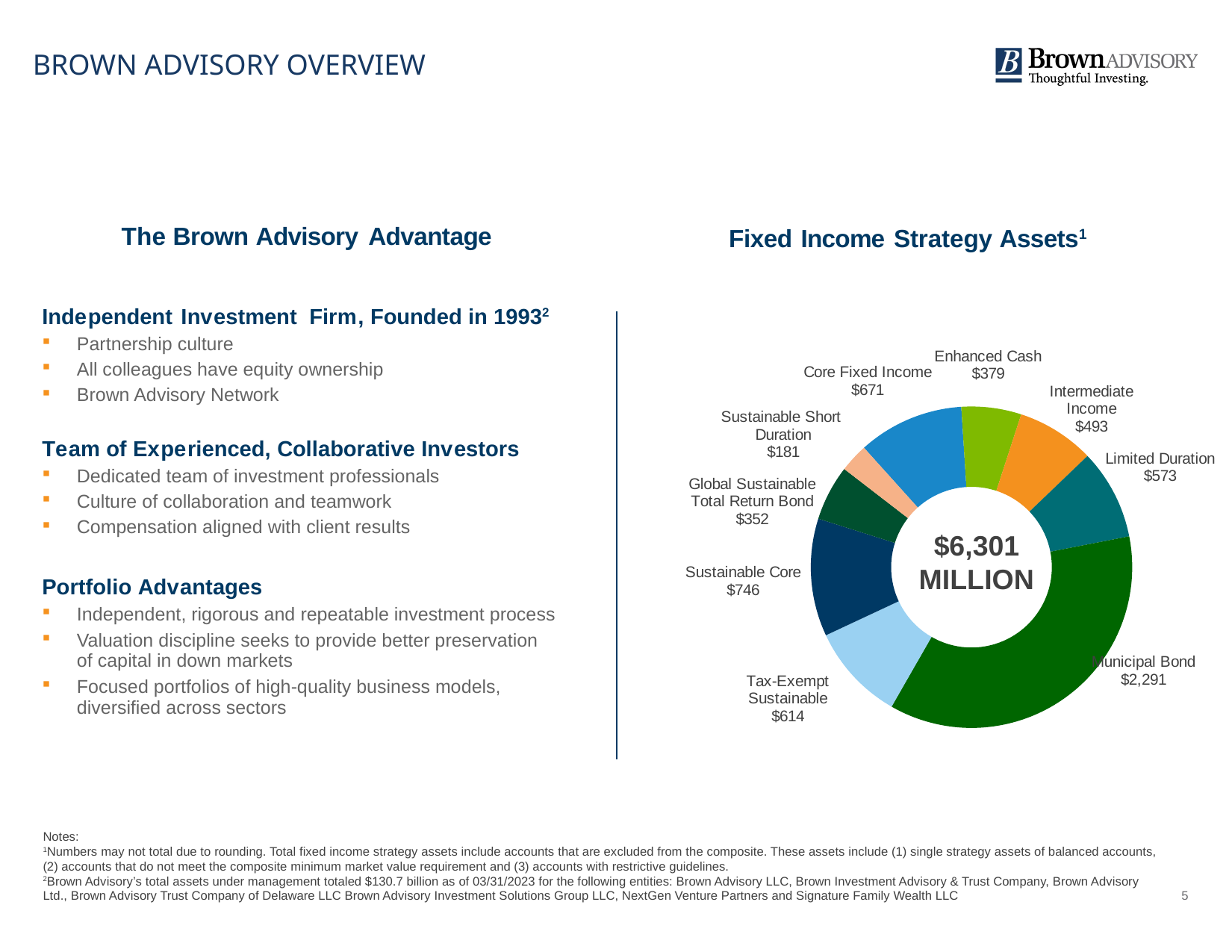
In the Fixed Income Strategy Assets chart, what is the value for Sustainable Short Duration? $181 In the Fixed Income Strategy Assets chart, what is the value for Tax-Exempt Sustainable? $614 Which category has the smallest value in the Fixed Income Strategy Assets chart? Sustainable Short Duration In the Fixed Income Strategy Assets chart, which is larger: Limited Duration or Intermediate Income? Limited Duration In the Fixed Income Strategy Assets chart, what is the difference between Municipal Bond and Sustainable Core? $1,545 What type of chart is shown under "Fixed Income Strategy Assets"? Pie chart (donut) In the Fixed Income Strategy Assets chart, what is the difference between Core Fixed Income and Enhanced Cash? $292 In the Fixed Income Strategy Assets chart, what is the value for Municipal Bond? $2,291 In the Fixed Income Strategy Assets chart, what is the value for Global Sustainable Total Return Bond? $352 Which category has the largest value in the Fixed Income Strategy Assets chart? Municipal Bond What total is printed in the center of the Fixed Income Strategy Assets chart? $6,301 MILLION How many categories are shown in the Fixed Income Strategy Assets chart? 9